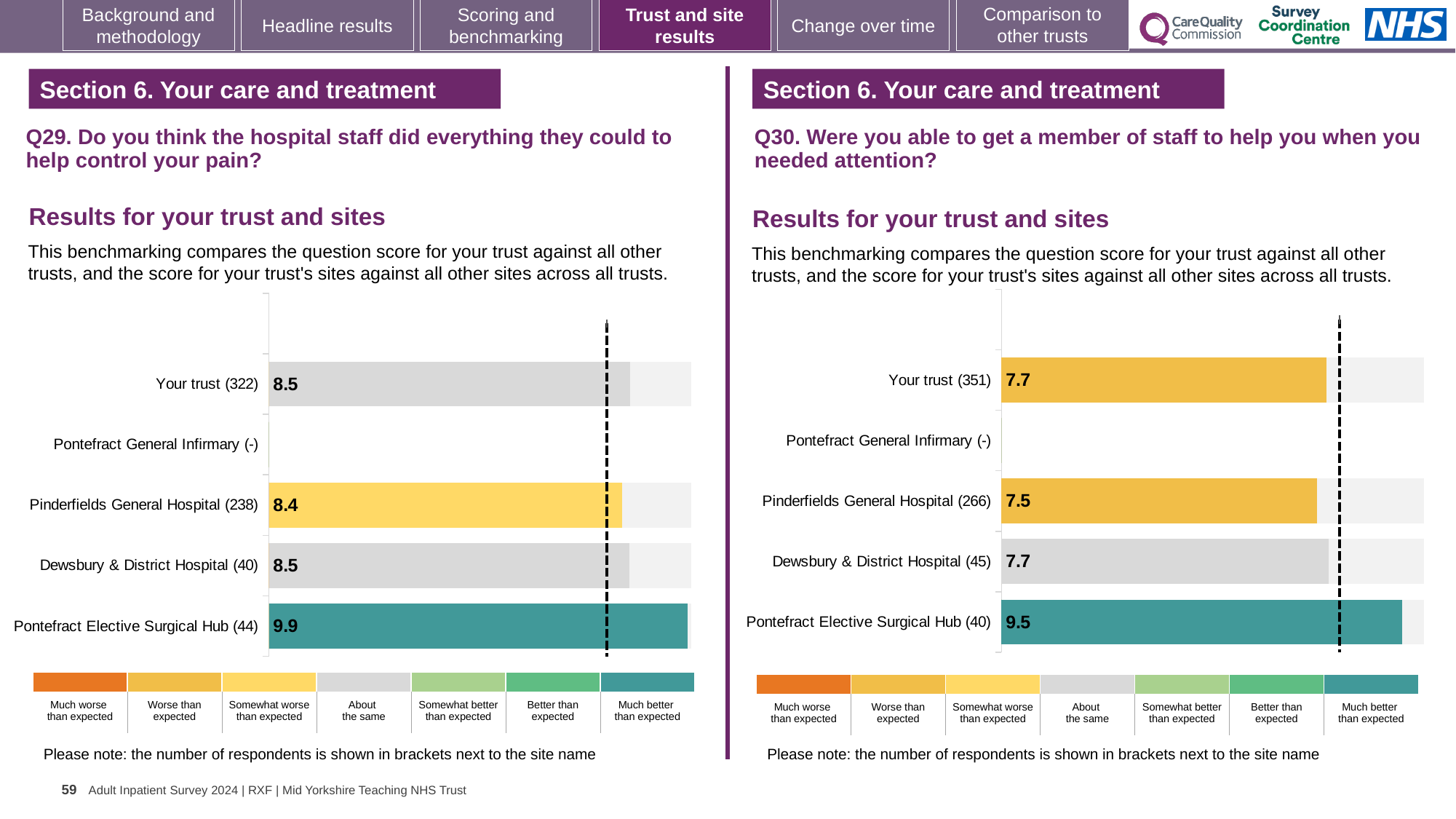
In the Q30 chart on the right, what is the score for Pinderfields General Hospital (266)? 7.5 What kind of chart is used for the Q30 results on the right? Bar chart In the Q30 chart on the right, what is the score for Your trust (351)? 7.7 In the Q29 chart on the left, what is the difference between the scores for Pontefract Elective Surgical Hub (44) and Your trust (322)? 1.4 In the Q29 chart on the left, which site has the highest score? Pontefract Elective Surgical Hub (44) In the Q29 chart on the left, what is the score for Pinderfields General Hospital (238)? 8.4 How many site/trust categories are listed on the Q29 chart on the left? 5 In the Q29 chart on the left, what is the score for Pontefract Elective Surgical Hub (44)? 9.9 In the Q30 chart on the right, which has the larger score: Your trust (351) or Pinderfields General Hospital (266)? Your trust (351) In the Q30 chart on the right, what is the difference between the scores for Pontefract Elective Surgical Hub (40) and Dewsbury & District Hospital (45)? 1.8 In the Q29 chart on the left, which benchmark category does the colour of the Pontefract Elective Surgical Hub (44) bar represent? Much better than expected In the Q30 chart on the right, which site with a score shown has the lowest score? Pinderfields General Hospital (266)